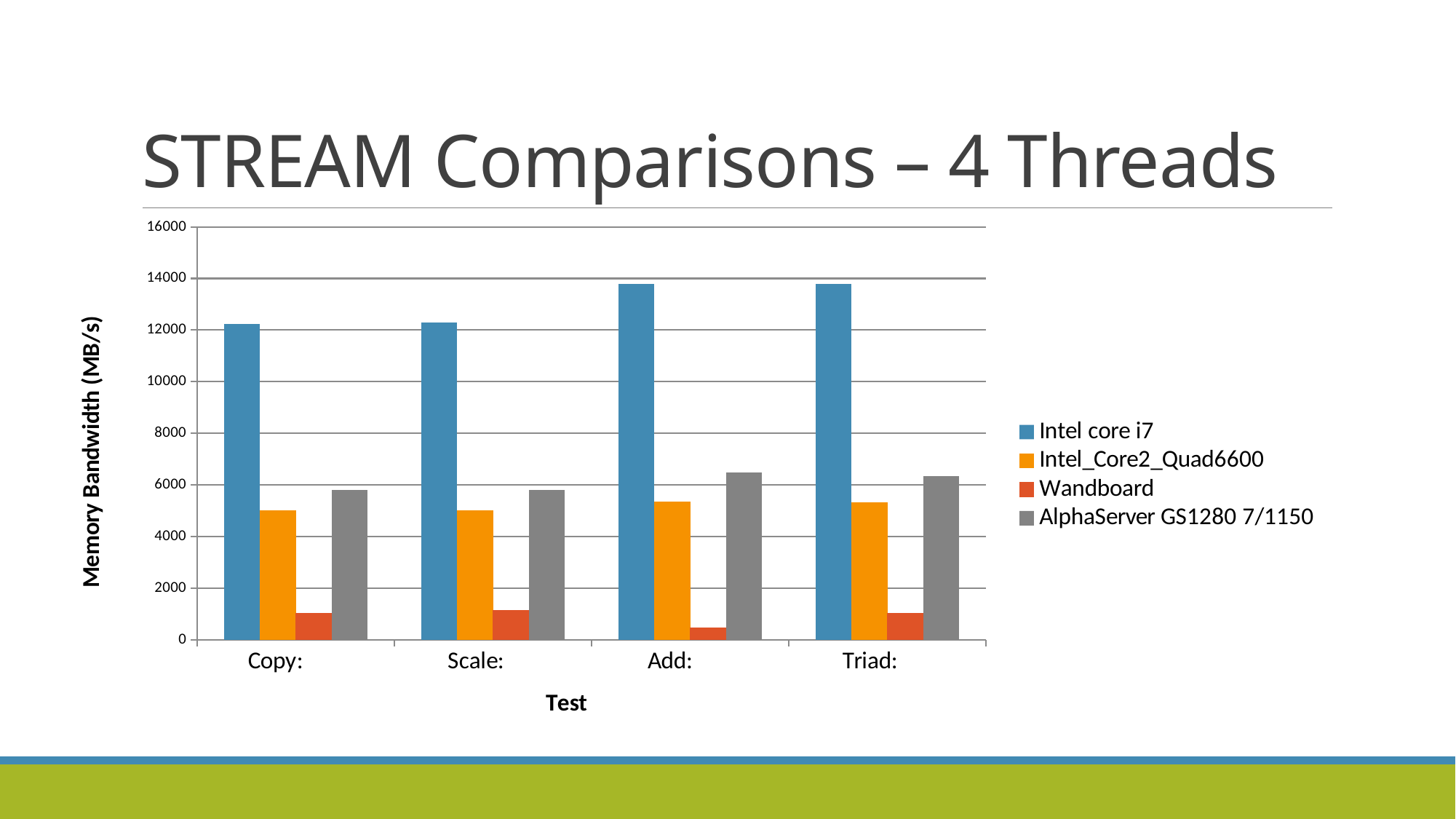
How many tests are shown along the x axis? 4 For the Triad test, which is larger: AlphaServer GS1280 7/1150 or Intel_Core2_Quad6600? AlphaServer GS1280 7/1150 What is the label of the y axis? Memory Bandwidth (MB/s) What kind of chart is shown on the slide? bar chart How many series does the legend list? 4 Is the Intel core i7 value for the Add test greater or less than 12000? greater Is the AlphaServer GS1280 7/1150 value for the Add test greater or less than 6000? greater Is the Intel_Core2_Quad6600 value for the Copy test greater or less than 6000? less For which test is the Wandboard value lowest? Add: Which series has the highest memory bandwidth for the Copy test? Intel core i7 Which series has the lowest memory bandwidth for the Add test? Wandboard